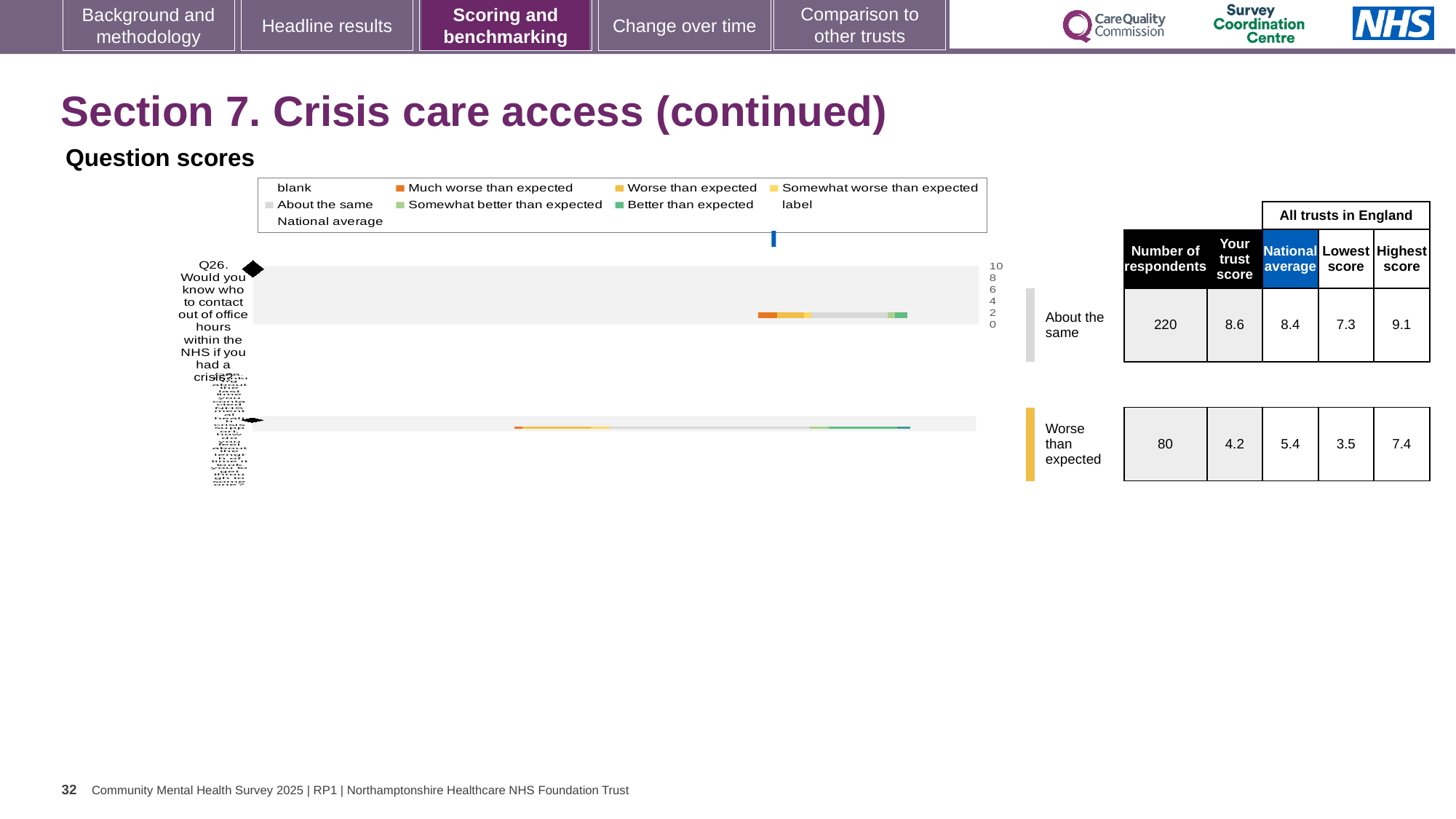
What kind of chart is used to show the question scores? Bar chart What is the lowest score among all trusts in England for Q26? 7.3 What is the highest score among all trusts in England for Q26? 9.1 What is the difference between the highest and lowest scores across all trusts in England for Q26? 1.8 How many respondents answered Q26? 220 What is the national average score for Q26? 8.4 Which benchmarking category is the trust's Q26 score placed in? About the same For Q26, which is larger: the trust score or the national average? The trust score Is the trust score for Q26 greater or less than 8? greater What is the trust score for Q26 (Would you know who to contact out of office hours within the NHS if you had a crisis?)? 8.6 What is the difference between the trust score and the national average for Q26? 0.2 Which benchmarking category is the second (lower) question row placed in? Worse than expected